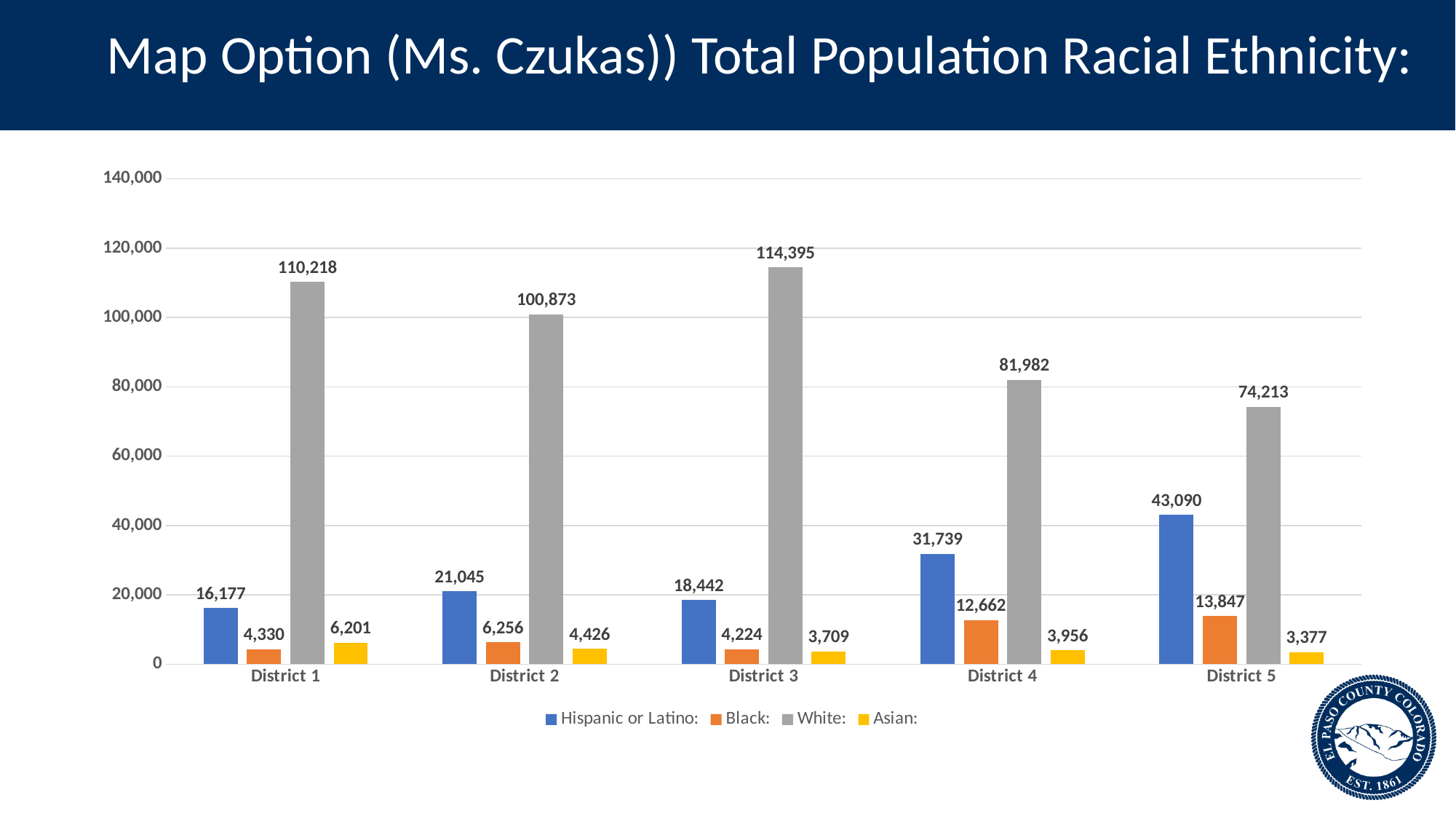
How many series does the legend list? 4 Which is larger, the Hispanic or Latino value for District 4 or for District 2? District 4 What is the difference between the White values for District 1 and District 2? 9,345 Which district has the lowest Asian value? District 5 Is the White value for District 4 greater or less than 80,000? greater What is the Hispanic or Latino value for District 5? 43,090 How many districts are shown on the x axis? 5 What is the Asian value for District 1? 6,201 What kind of chart is shown on the slide? Bar chart What is the Black value for District 4? 12,662 What is the White population value for District 3? 114,395 Which district has the highest White value? District 3